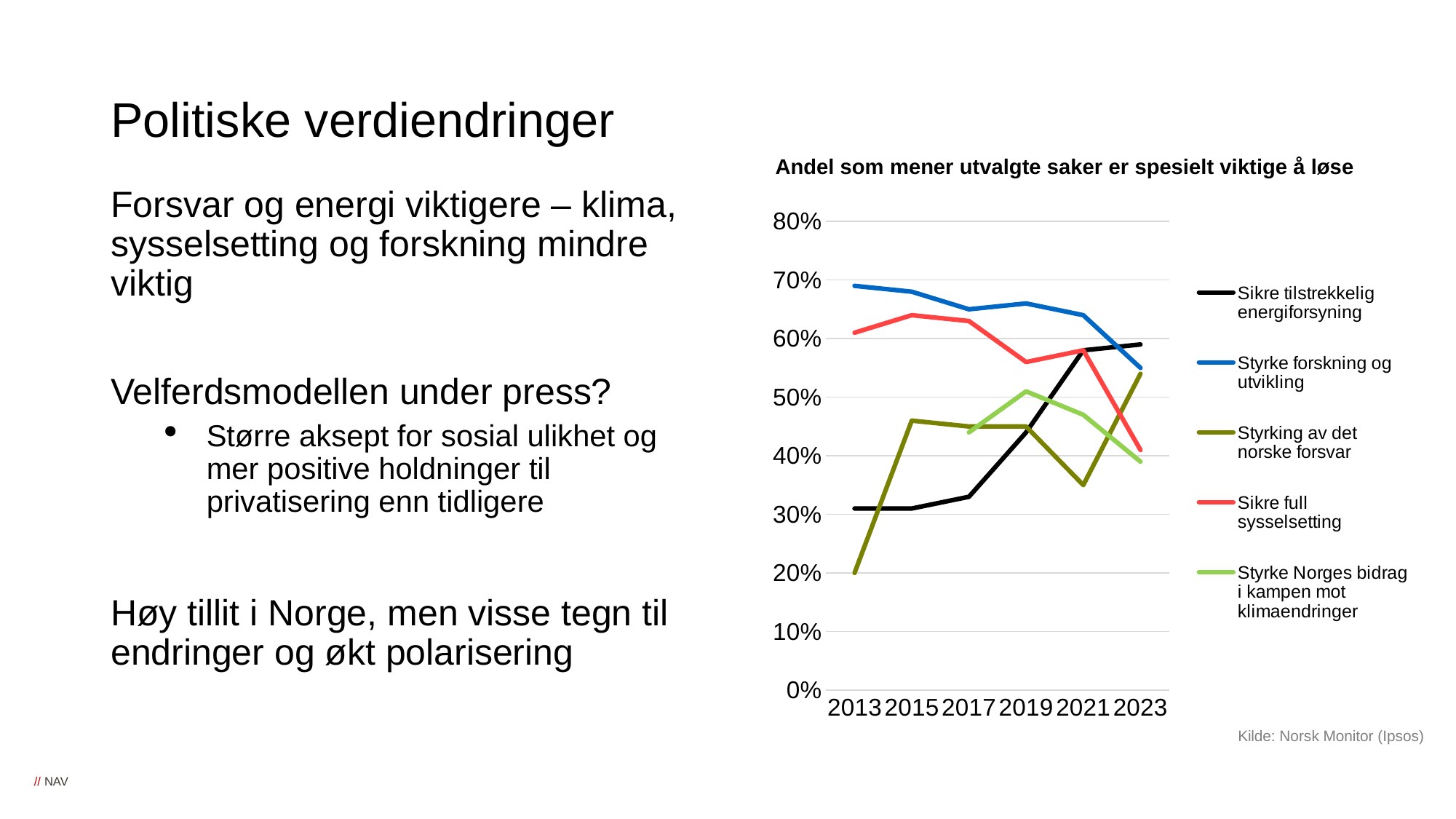
What kind of chart is shown on the slide? line chart What is the title of the chart? Andel som mener utvalgte saker er spesielt viktige å løse Which series has the highest value in 2013? Styrke forskning og utvikling In 2023, which is larger: 'Sikre tilstrekkelig energiforsyning' or 'Sikre full sysselsetting'? Sikre tilstrekkelig energiforsyning Which series has the lowest value in 2013? Styrking av det norske forsvar Is the value for 'Styrke forskning og utvikling' in 2013 greater or less than 60%? greater Is the value for 'Sikre tilstrekkelig energiforsyning' in 2013 greater or less than 40%? less Does the value for 'Sikre tilstrekkelig energiforsyning' rise or fall from 2013 to 2023? rise Is the value for 'Styrking av det norske forsvar' in 2013 greater or less than 30%? less How many years are shown on the x axis? 6 How many series does the legend list? 5